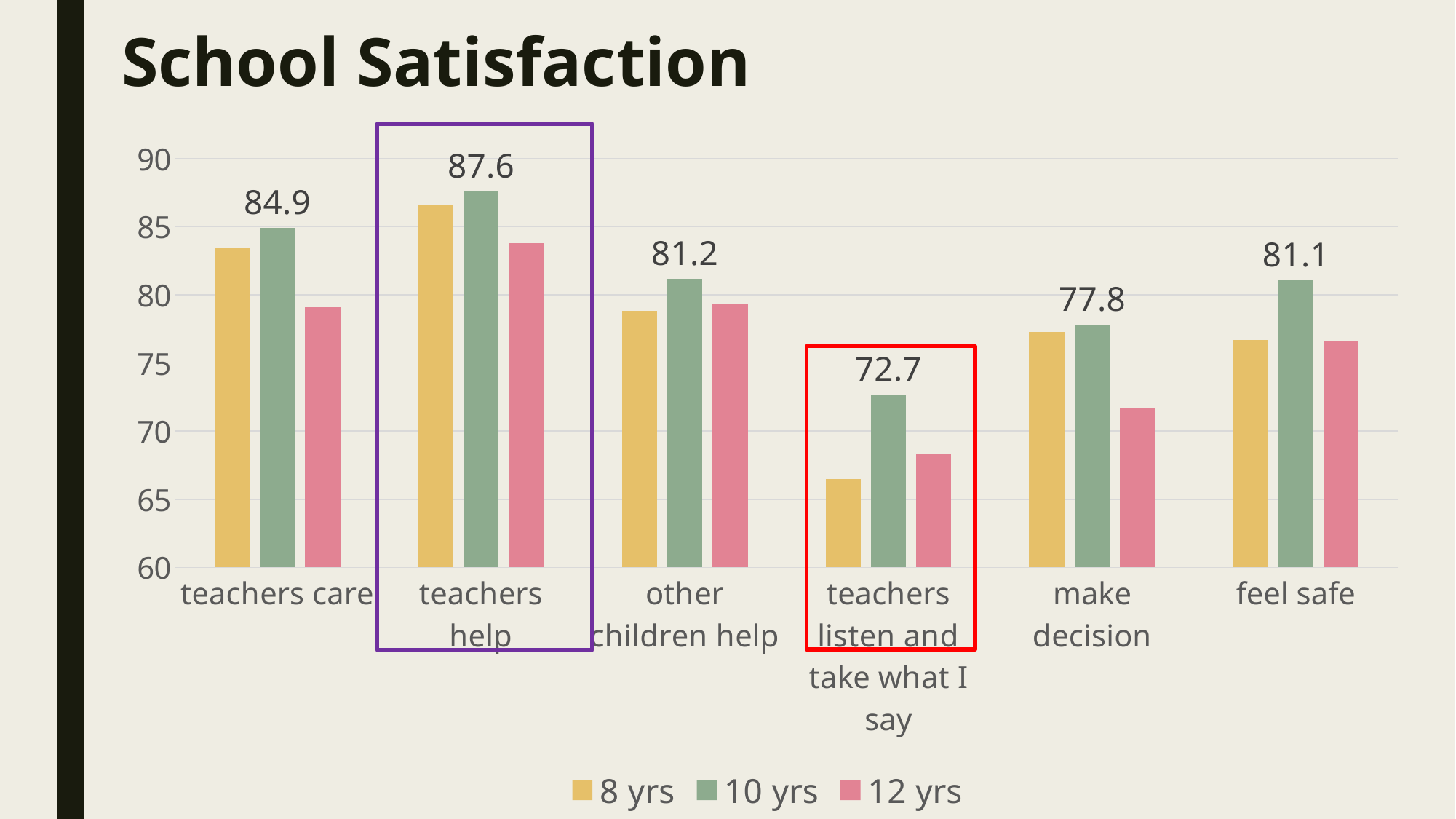
What is the difference between the 10 yrs values for 'teachers help' and 'teachers listen and take what I say'? 14.9 Is the value for the 12 yrs series in 'make decision' greater or less than 75? less For the 10 yrs series, which is larger: 'teachers care' or 'make decision'? teachers care Is the value for the 8 yrs series in 'teachers listen and take what I say' greater or less than 70? less What is the value for the 10 yrs series in the 'make decision' category? 77.8 What is the value for the 10 yrs series in the 'teachers help' category? 87.6 How many series does the legend list? 3 How many categories are shown on the x axis? 6 What is the value for the 10 yrs series in the 'teachers listen and take what I say' category? 72.7 What type of chart is shown on the slide? bar chart Which category has the highest value for the 10 yrs series? teachers help Which category has the lowest value for the 10 yrs series? teachers listen and take what I say